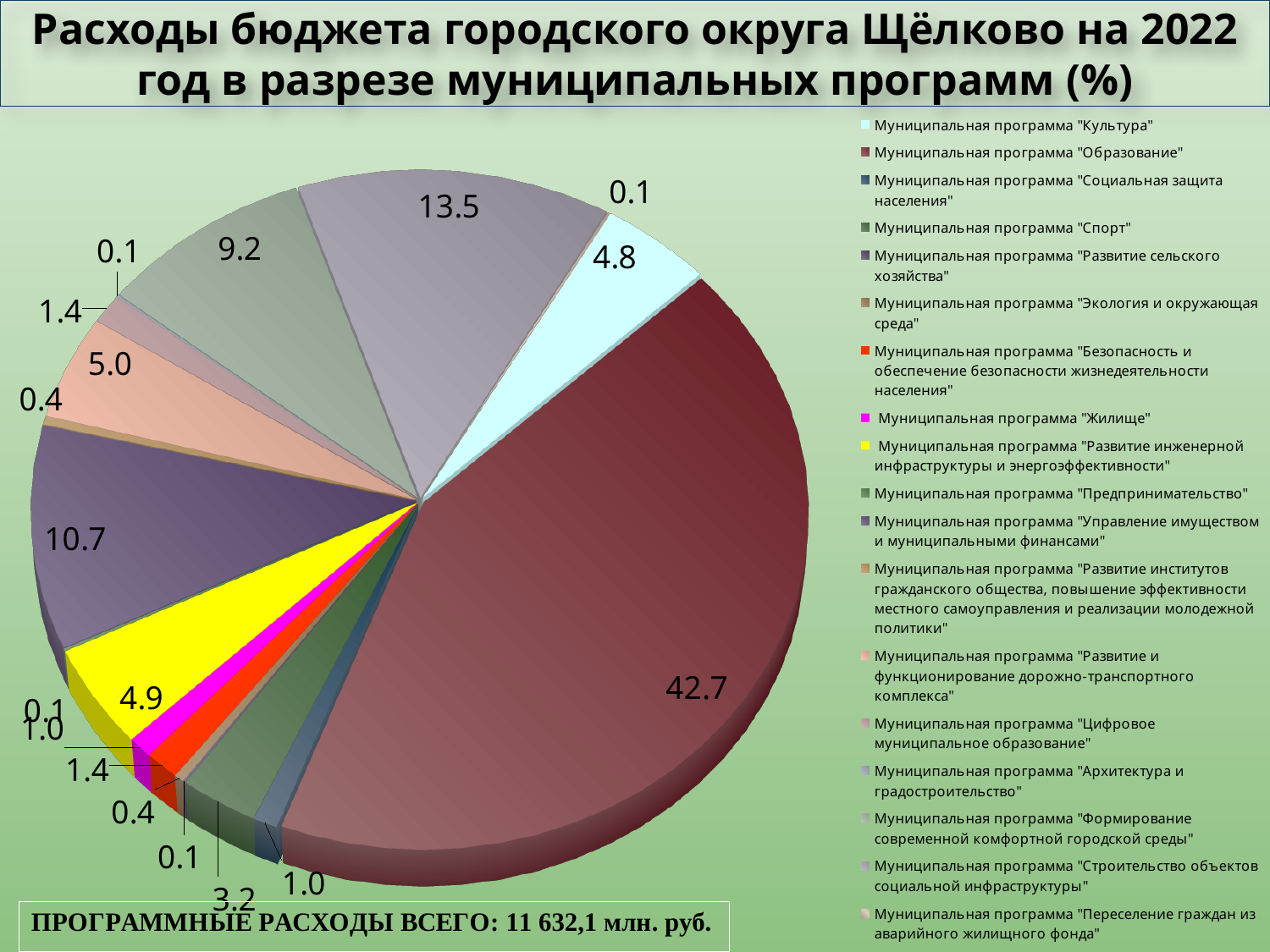
What is the difference in percentage points between the "Образование" programme and the "Строительство объектов социальной инфраструктуры" programme? 29.2 What percentage of expenditure goes to the municipal programme "Образование"? 42.7 How many municipal programmes are listed in the legend? 18 What percentage of expenditure goes to the municipal programme "Строительство объектов социальной инфраструктуры"? 13.5 What percentage of expenditure goes to the municipal programme "Формирование современной комфортной городской среды"? 9.2 What percentage of expenditure goes to the municipal programme "Культура"? 4.8 What percentage of expenditure goes to the municipal programme "Управление имуществом и муниципальными финансами"? 10.7 What is the total programme expenditure stated at the bottom of the slide? 11 632,1 млн. руб. What colour is the slice for the municipal programme "Образование"? Dark red What kind of chart is shown on the slide? Pie chart Which municipal programme has the largest share of the 2022 budget expenditure? Муниципальная программа "Образование" Which has a larger share: the "Управление имуществом и муниципальными финансами" programme or the "Строительство объектов социальной инфраструктуры" programme? Строительство объектов социальной инфраструктуры